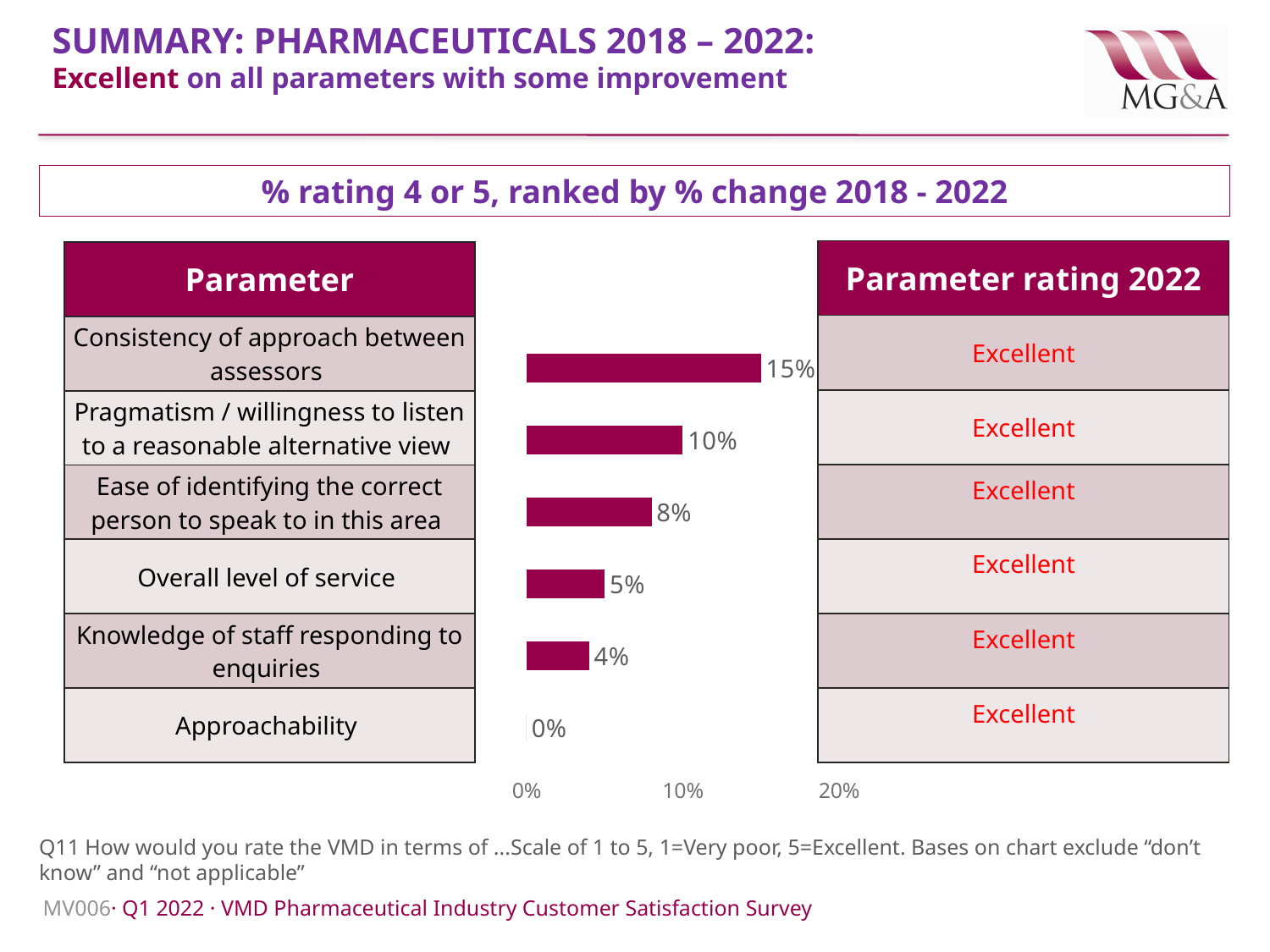
What is the % change for Approachability? 0% Which parameter has the lowest % change 2018 - 2022? Approachability What is the % change for Pragmatism / willingness to listen to a reasonable alternative view? 10% Which parameter has the highest % change 2018 - 2022? Consistency of approach between assessors Which has a larger % change: Ease of identifying the correct person to speak to in this area or Knowledge of staff responding to enquiries? Ease of identifying the correct person to speak to in this area What is the % change for Ease of identifying the correct person to speak to in this area? 8% What is the difference in % change between Consistency of approach between assessors and Overall level of service? 10% What is the % change for Consistency of approach between assessors? 15% What is the % change for Overall level of service? 5% What is the % change for Knowledge of staff responding to enquiries? 4% What type of chart is shown on the slide? Bar chart How many parameters are shown in the chart? 6